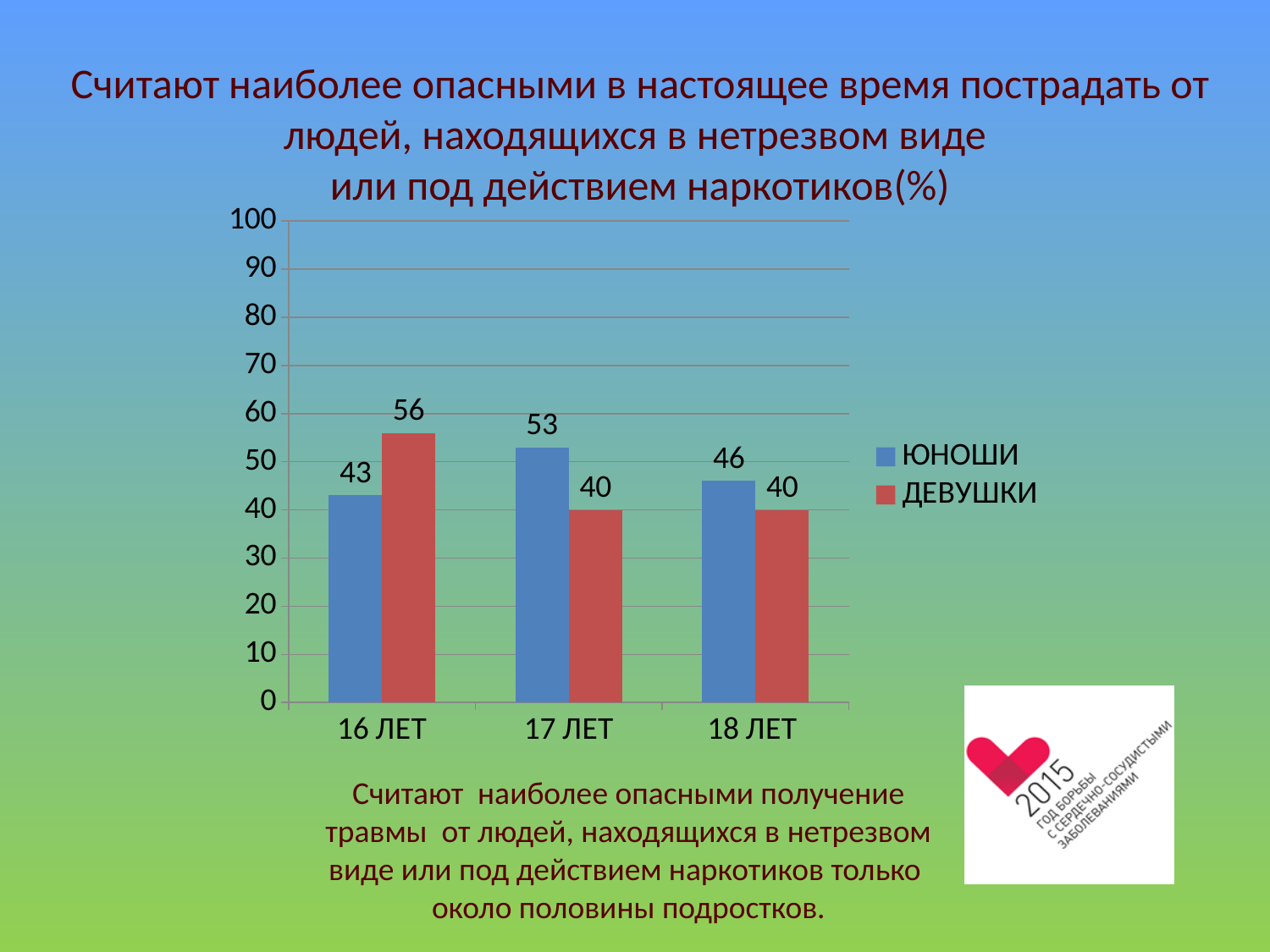
What is the value for ДЕВУШКИ at 18 ЛЕТ? 40 At which age group is the value for ЮНОШИ highest? 17 ЛЕТ Which is larger at 17 ЛЕТ, ЮНОШИ or ДЕВУШКИ? ЮНОШИ Which colour represents ДЕВУШКИ in the chart? red What is the value for ДЕВУШКИ at 16 ЛЕТ? 56 What is the value for ЮНОШИ at 17 ЛЕТ? 53 What is the difference between ДЕВУШКИ and ЮНОШИ at 16 ЛЕТ? 13 What is the value for ЮНОШИ at 16 ЛЕТ? 43 At which age group is the value for ЮНОШИ lowest? 16 ЛЕТ How many age groups are shown on the x axis? 3 What kind of chart is shown on the slide? bar chart How many series does the legend list? 2